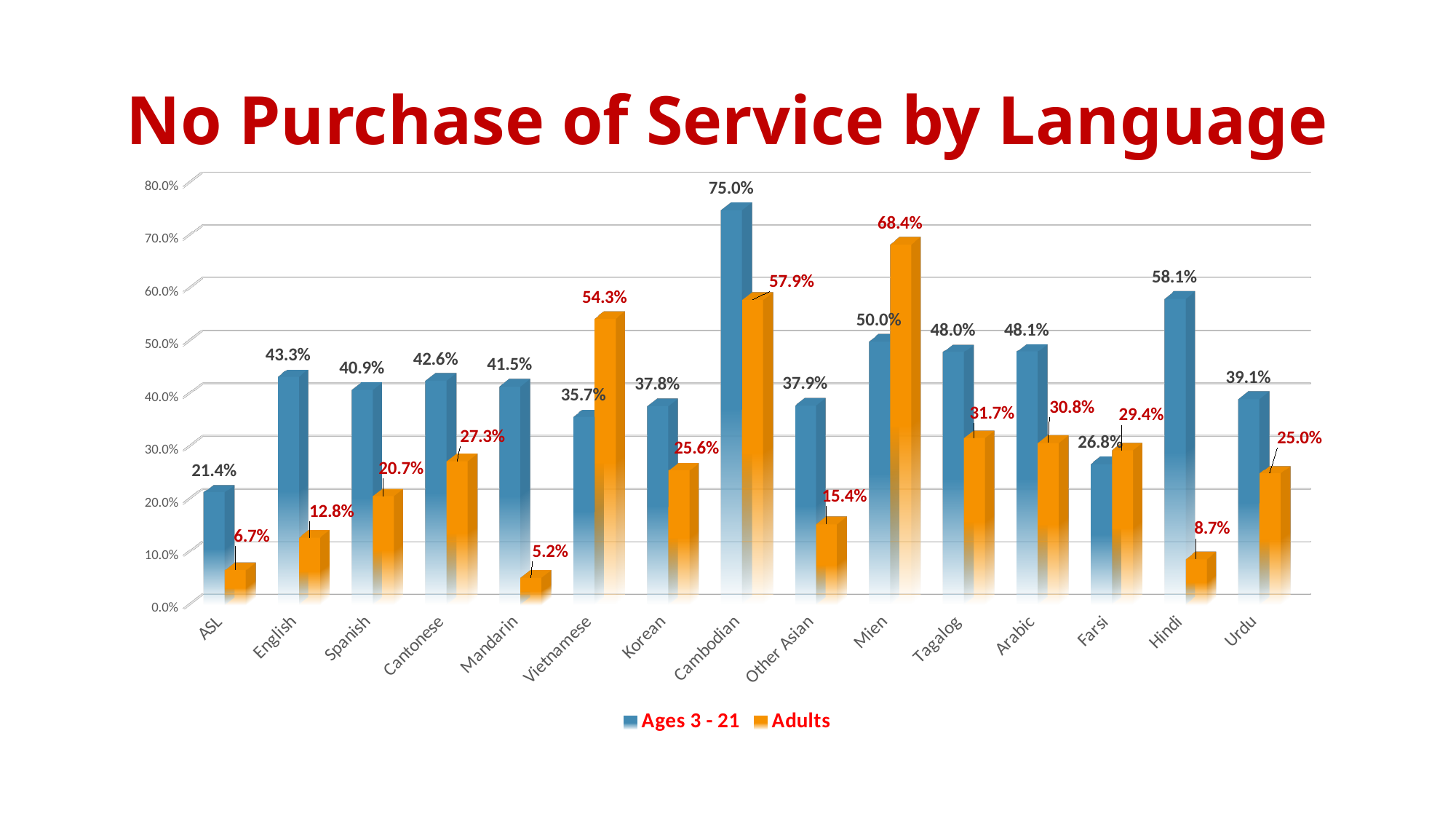
For Vietnamese, which series has the larger value, Ages 3 - 21 or Adults? Adults What is the Ages 3 - 21 value for Cambodian? 75.0% What is the Adults value for Mandarin? 5.2% What is the Ages 3 - 21 value for Hindi? 58.1% What type of chart is shown on the slide? Bar chart How many series does the legend list? 2 Which language has the lowest Adults value? Mandarin Which language has the lowest Ages 3 - 21 value? ASL How many languages are shown on the x axis? 15 Which language has the highest Ages 3 - 21 value? Cambodian What is the Adults value for Mien? 68.4% What is the difference between the Ages 3 - 21 and Adults values for Hindi? 49.4%